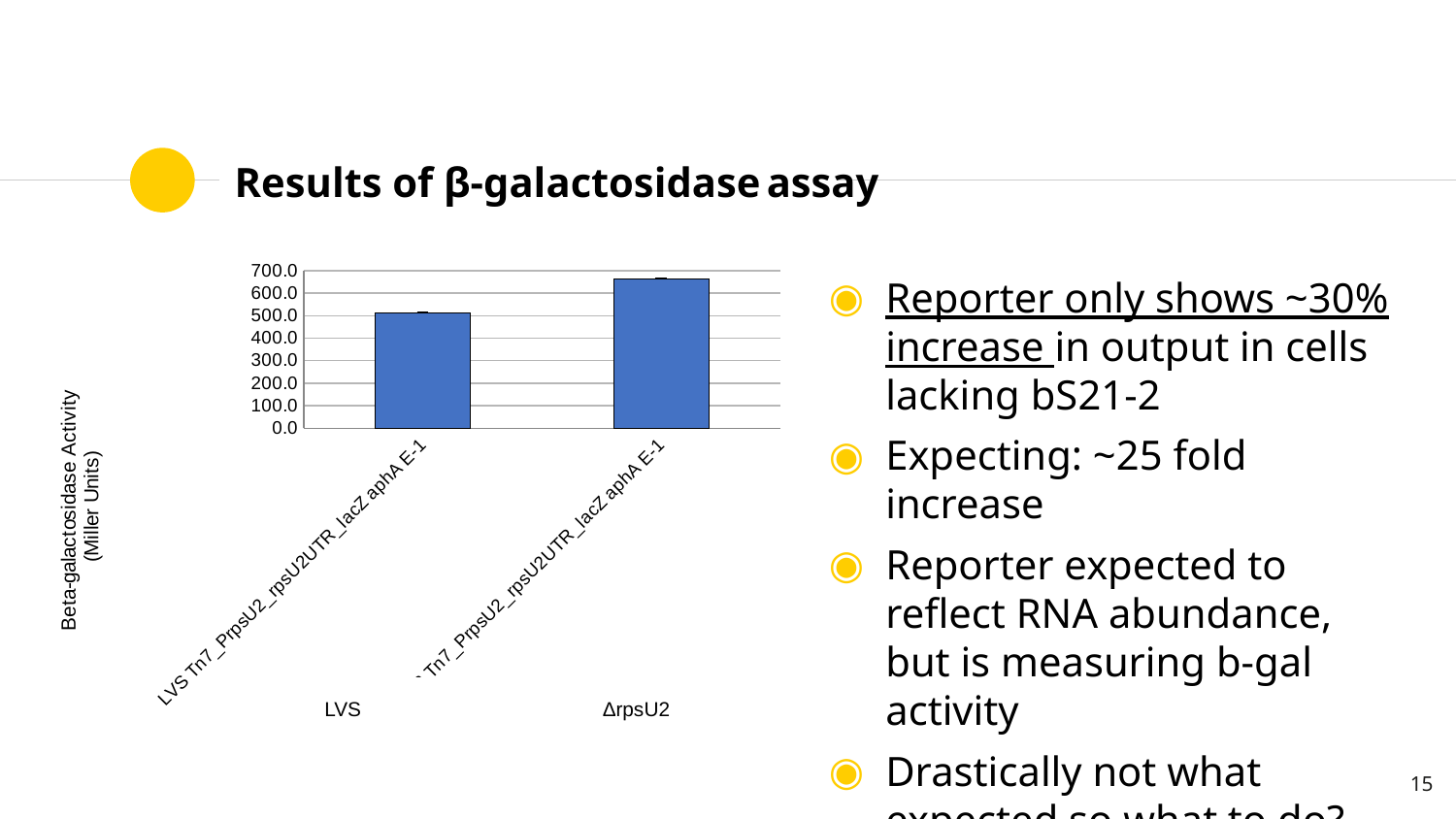
Is the value for LVS greater or less than 600.0? less Is the value for ΔrpsU2 larger or smaller than the value for LVS? larger Which category has the highest beta-galactosidase activity, LVS or ΔrpsU2? ΔrpsU2 Is the value for ΔrpsU2 greater or less than 600.0? greater Is the value for LVS greater or less than 400.0? greater What is the highest tick value shown on the y axis of the chart? 700.0 What kind of chart is shown on the slide? bar chart What units are given for the y axis of the chart? Miller Units Which category has the lowest beta-galactosidase activity, LVS or ΔrpsU2? LVS How many bars are plotted in the chart? 2